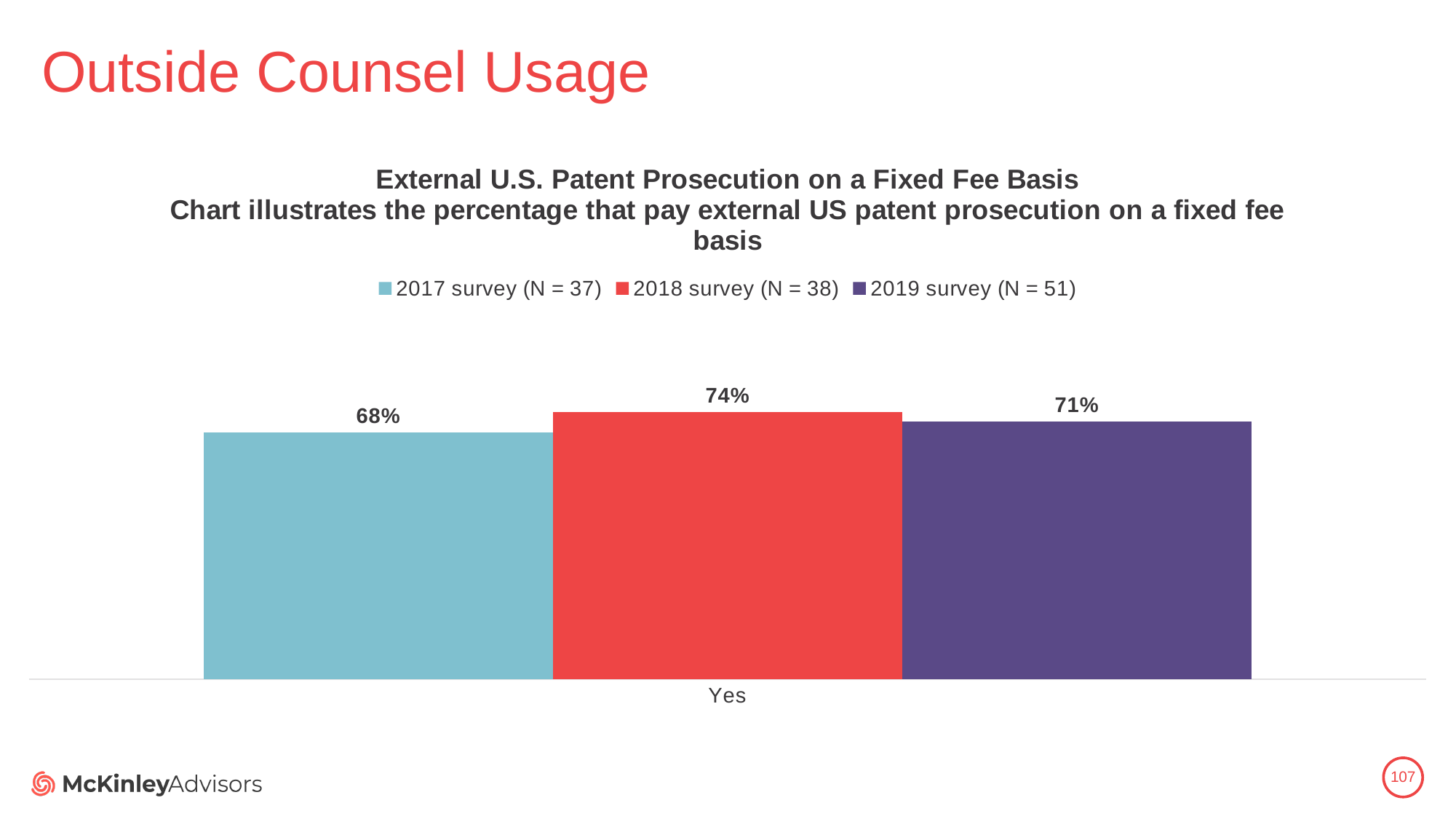
What percentage is shown for the 2018 survey (N = 38)? 74% Which survey year has the lowest percentage paying external US patent prosecution on a fixed fee basis? 2017 survey (N = 37) How many series does the legend list? 3 What is the difference in percentage points between the 2018 survey and the 2017 survey? 6 What is the difference in percentage points between the 2018 survey and the 2019 survey? 3 What percentage is shown for the 2019 survey (N = 51)? 71% What percentage is shown for the 2017 survey (N = 37)? 68% Which survey year has the highest percentage paying external US patent prosecution on a fixed fee basis? 2018 survey (N = 38) What is the category label shown on the x axis? Yes What kind of chart is shown on the slide? Bar chart Which is larger, the value for the 2019 survey or the value for the 2017 survey? 2019 survey What colour is the bar for the 2018 survey (N = 38)? Red